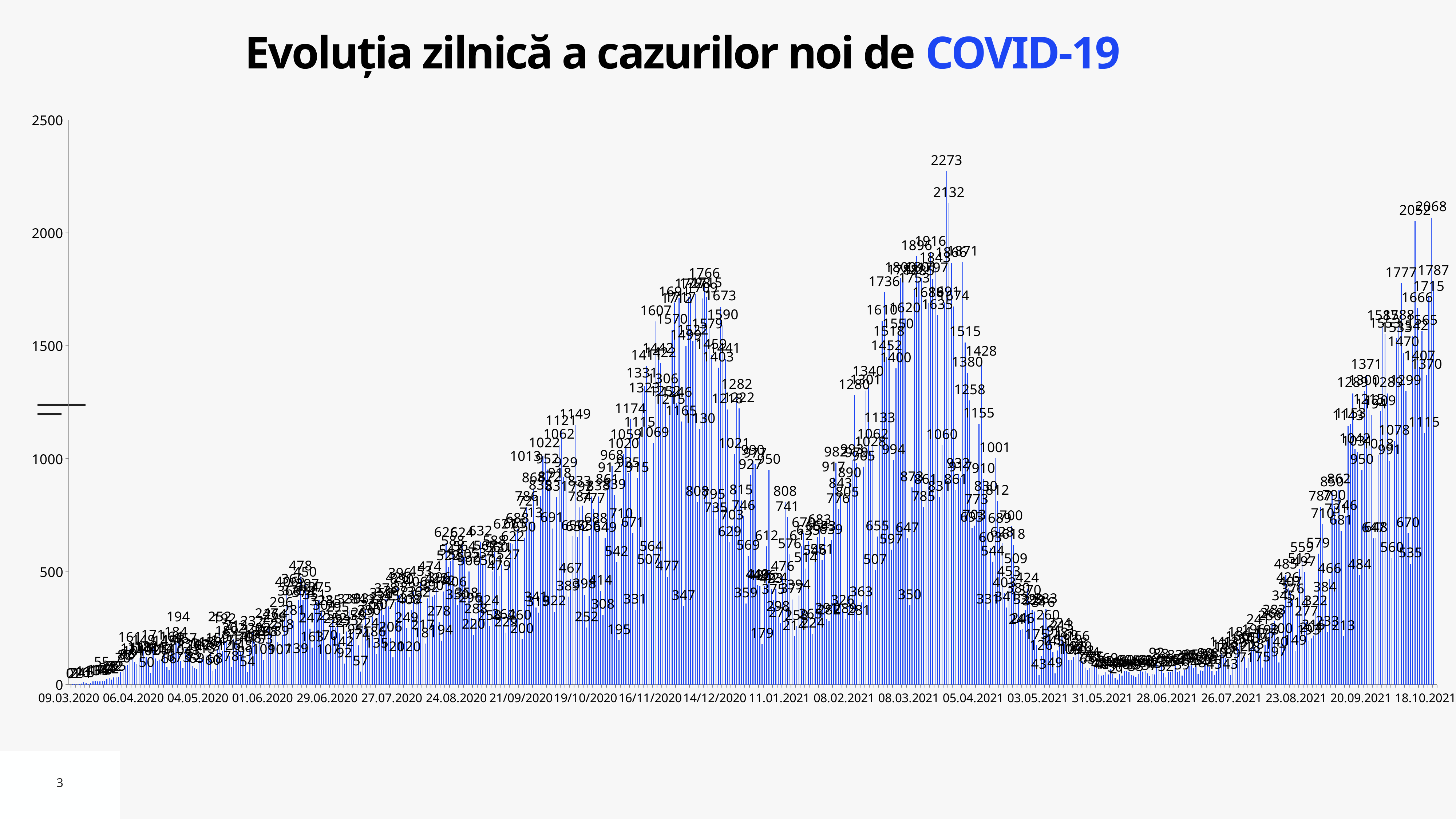
What is the highest value labelled at the peak around 14/12/2020? 1766 What is the highest daily value labelled on the chart? 2273 Which peak is higher: the one around 05.04.2021 or the one around 14/12/2020? the one around 05.04.2021 Is the highest bar on the chart greater or less than 2000? greater Do the values rise or fall between 05.04.2021 and 31.05.2021? fall What is the title of the chart? Evoluția zilnică a cazurilor noi de COVID-19 What is the highest tick value shown on the vertical axis? 2500 What kind of chart is shown on the slide? bar chart What is the first date shown on the horizontal axis? 09.03.2020 Are the values around 31.05.2021 greater or less than 500? less What is the difference between the two highest labelled values, 2273 and 2132? 141 What is the second-highest daily value labelled on the chart, next to the 2273 peak? 2132